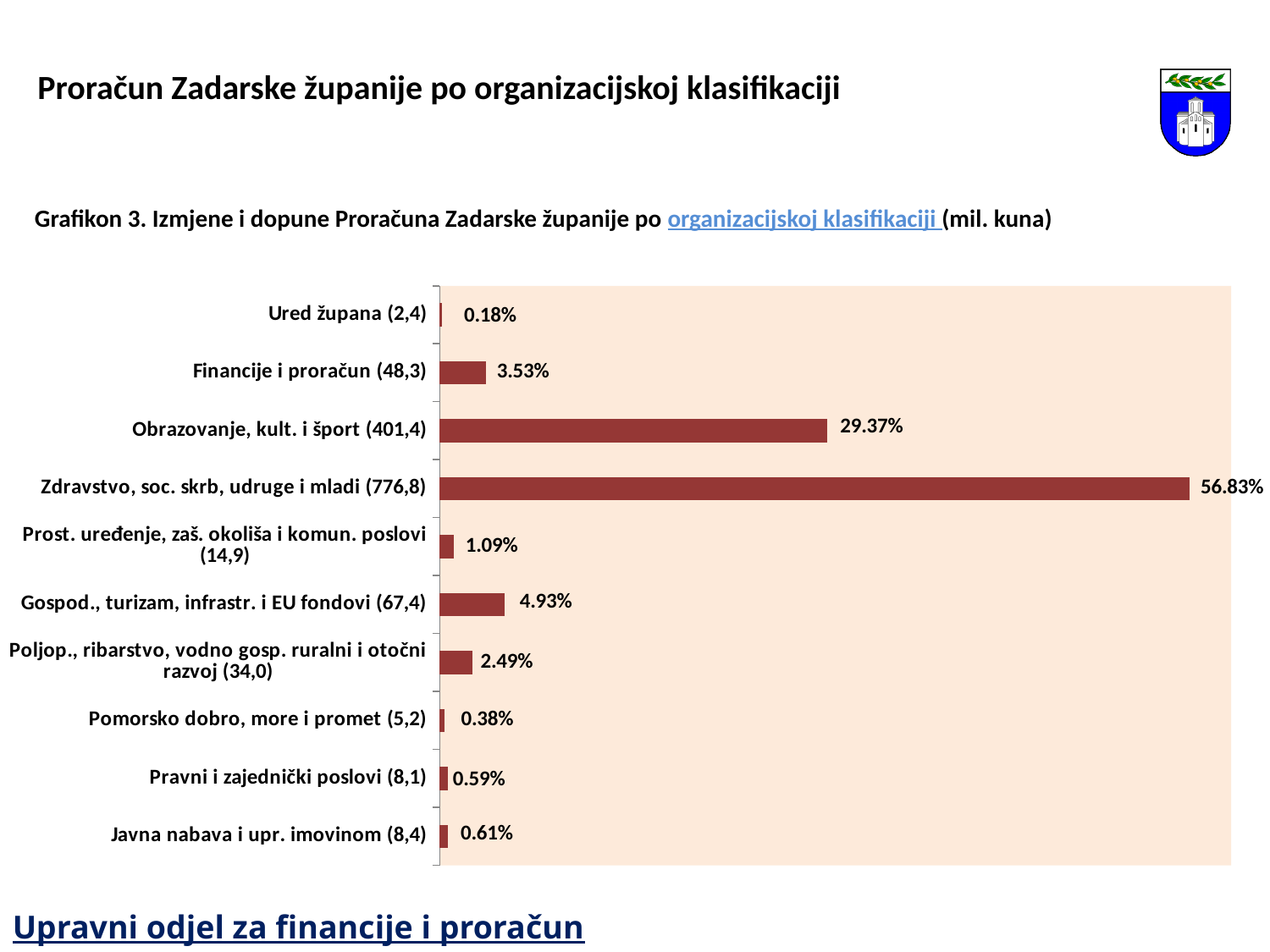
What type of chart is shown on the slide? Bar chart What percentage is shown for Pomorsko dobro, more i promet? 0.38% How many categories are shown in the chart? 10 What percentage is shown for Gospod., turizam, infrastr. i EU fondovi? 4.93% What unit is stated in the chart title for the values in parentheses? mil. kuna Which category has the highest percentage? Zdravstvo, soc. skrb, udruge i mladi Which category has the lowest percentage? Ured župana What is the difference in percentage points between Zdravstvo, soc. skrb, udruge i mladi and Obrazovanje, kult. i šport? 27.46 Which has a larger percentage, Gospod., turizam, infrastr. i EU fondovi or Financije i proračun? Gospod., turizam, infrastr. i EU fondovi What percentage is shown for Financije i proračun? 3.53% What percentage is shown for Zdravstvo, soc. skrb, udruge i mladi? 56.83% What percentage is shown for Obrazovanje, kult. i šport? 29.37%